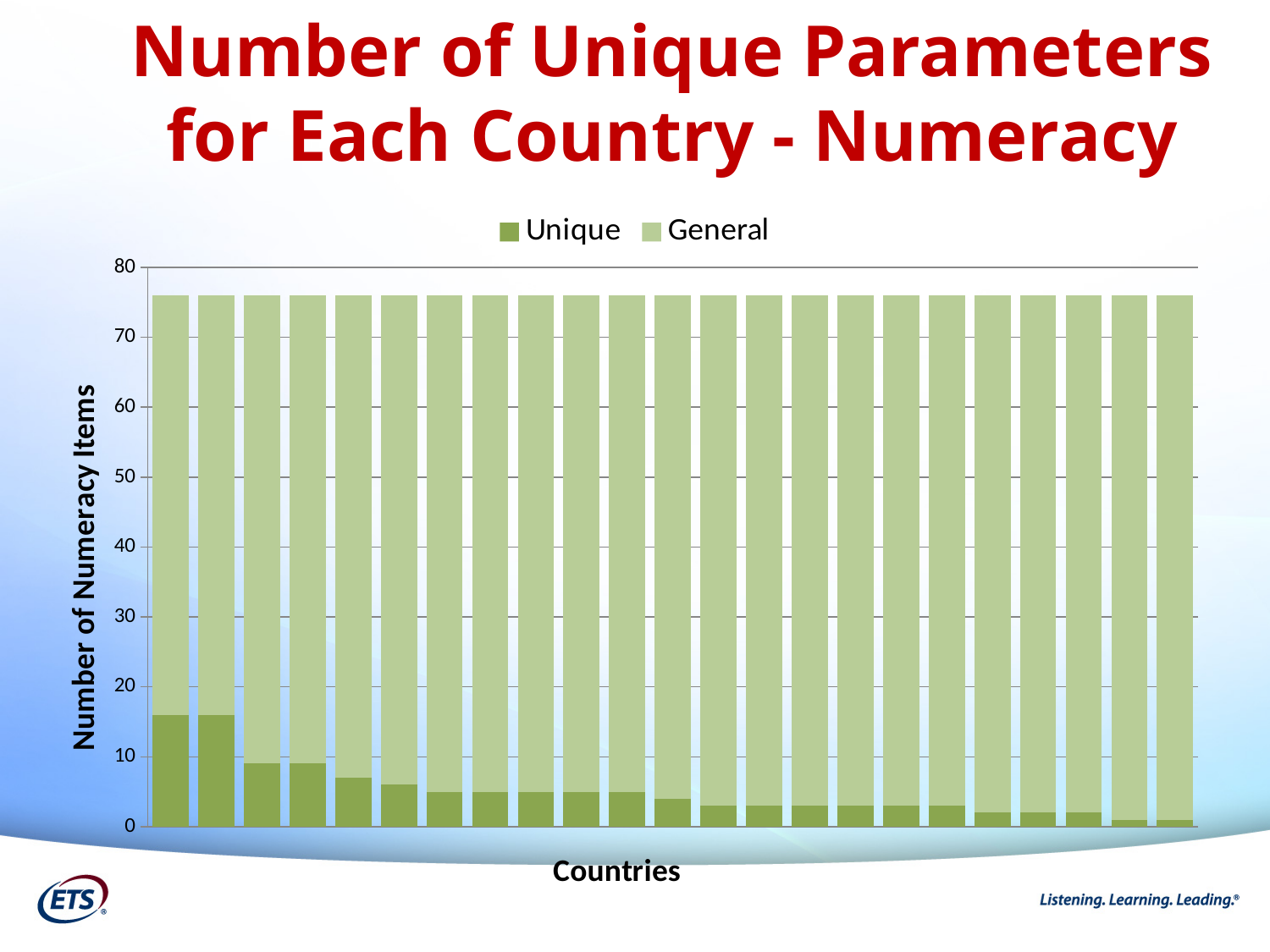
Do the Unique values rise or fall moving from left to right along the x axis? Fall Is the total height of the leftmost stacked bar greater or less than 70? greater What are the two series named in the legend? Unique and General Which is larger for the leftmost bar, the Unique value or the General value? General How many bars (countries) are plotted in the chart? 23 How many series does the legend list? 2 What kind of chart is shown on the slide? Stacked bar chart Which bar has the larger Unique value, the leftmost bar or the rightmost bar? The leftmost bar What is the title of the vertical axis? Number of Numeracy Items Is the Unique value for the rightmost bar greater or less than 10? less Is the Unique value for the leftmost bar greater or less than 10? greater